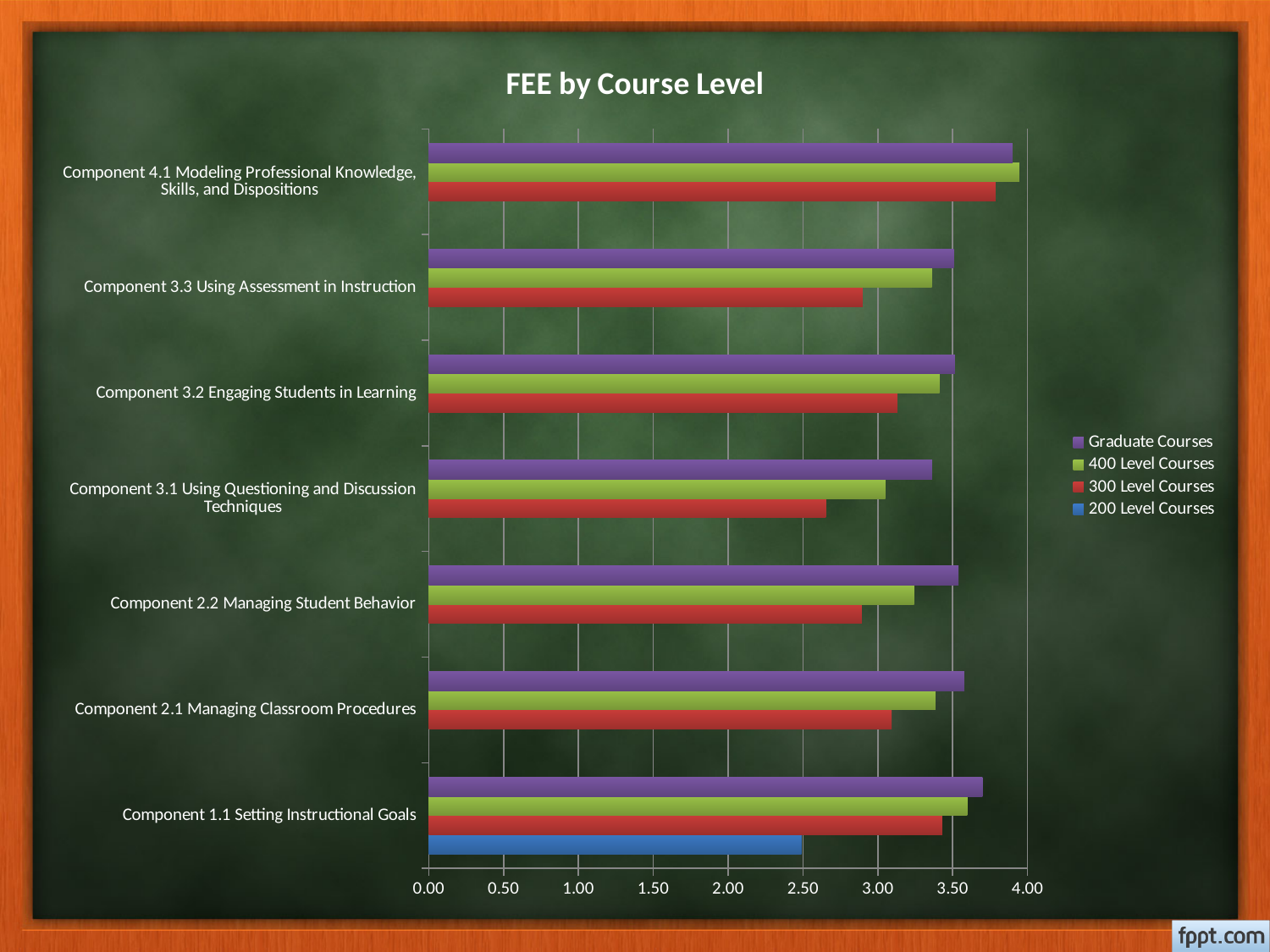
Is the value for 300 Level Courses for Component 3.3 Using Assessment in Instruction greater or less than 3.00? less Which series has a bar for only one component? 200 Level Courses Is the value for Graduate Courses for Component 4.1 Modeling Professional Knowledge, Skills, and Dispositions greater or less than 3.50? greater Which component has the lowest value for 300 Level Courses? Component 3.1 Using Questioning and Discussion Techniques For Component 3.3 Using Assessment in Instruction, which is larger: Graduate Courses or 300 Level Courses? Graduate Courses How many components (categories) are shown on the chart? 7 What is the title of the chart? FEE by Course Level Is the value for 300 Level Courses for Component 3.1 Using Questioning and Discussion Techniques greater or less than 2.50? greater What kind of chart is shown on the slide? bar chart Which component has the highest value for Graduate Courses? Component 4.1 Modeling Professional Knowledge, Skills, and Dispositions How many series does the legend list? 4